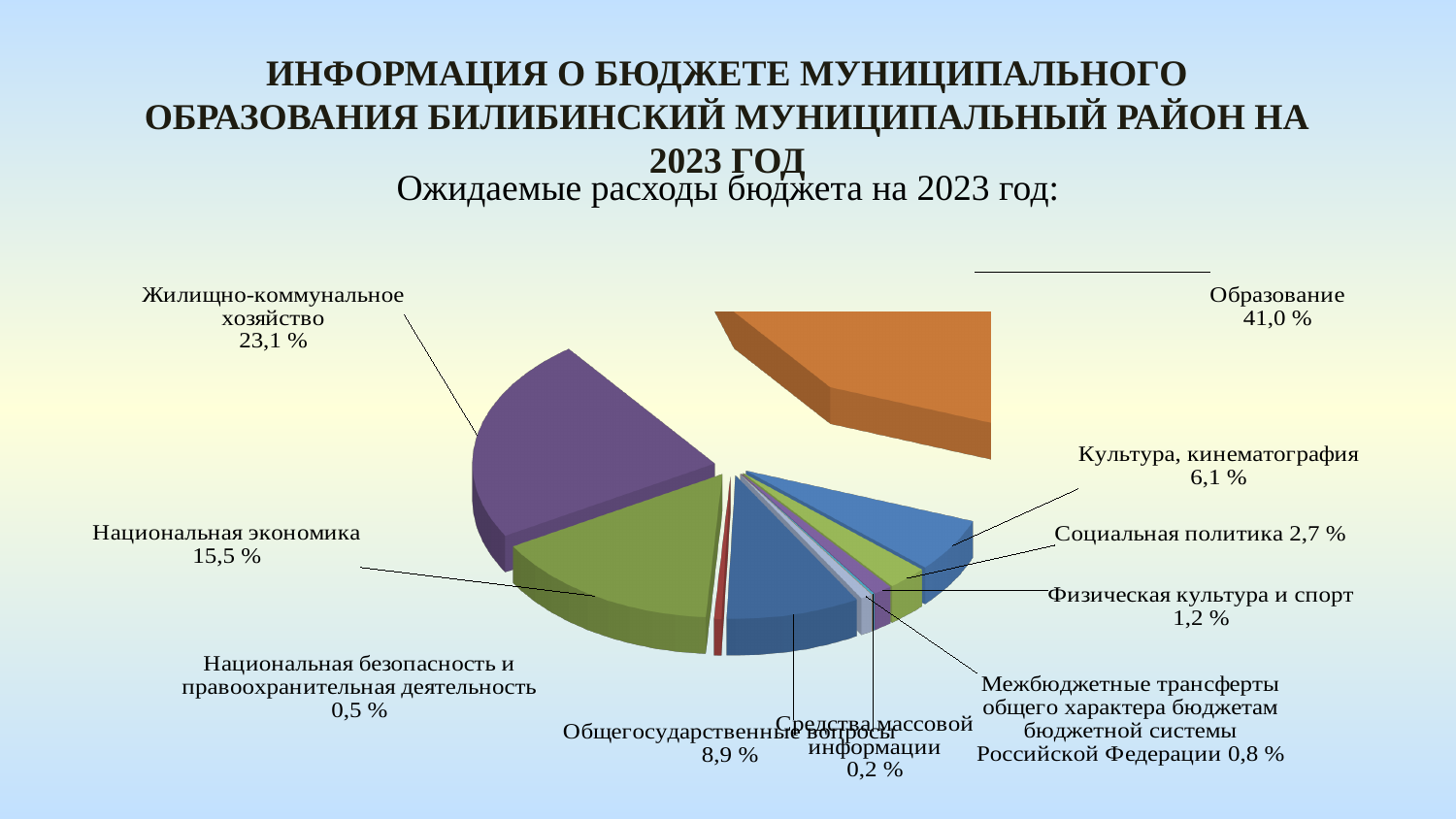
What is the value for Общегосударственные вопросы? 8,9 % What is the difference in percentage points between Образование and Жилищно-коммунальное хозяйство? 17,9 Which category has the largest share of the pie? Образование Which is larger: Социальная политика or Физическая культура и спорт? Социальная политика How many categories are shown in the pie chart? 10 What kind of chart is shown on the slide? Pie chart What is the subtitle of the chart on the slide? Ожидаемые расходы бюджета на 2023 год: Which category has the smallest share of the pie? Средства массовой информации What percentage is shown for Национальная экономика? 15,5 % What share of expected 2023 budget expenditure goes to Образование? 41,0 % What is the value shown for Жилищно-коммунальное хозяйство? 23,1 % What share is shown for Культура, кинематография? 6,1 %